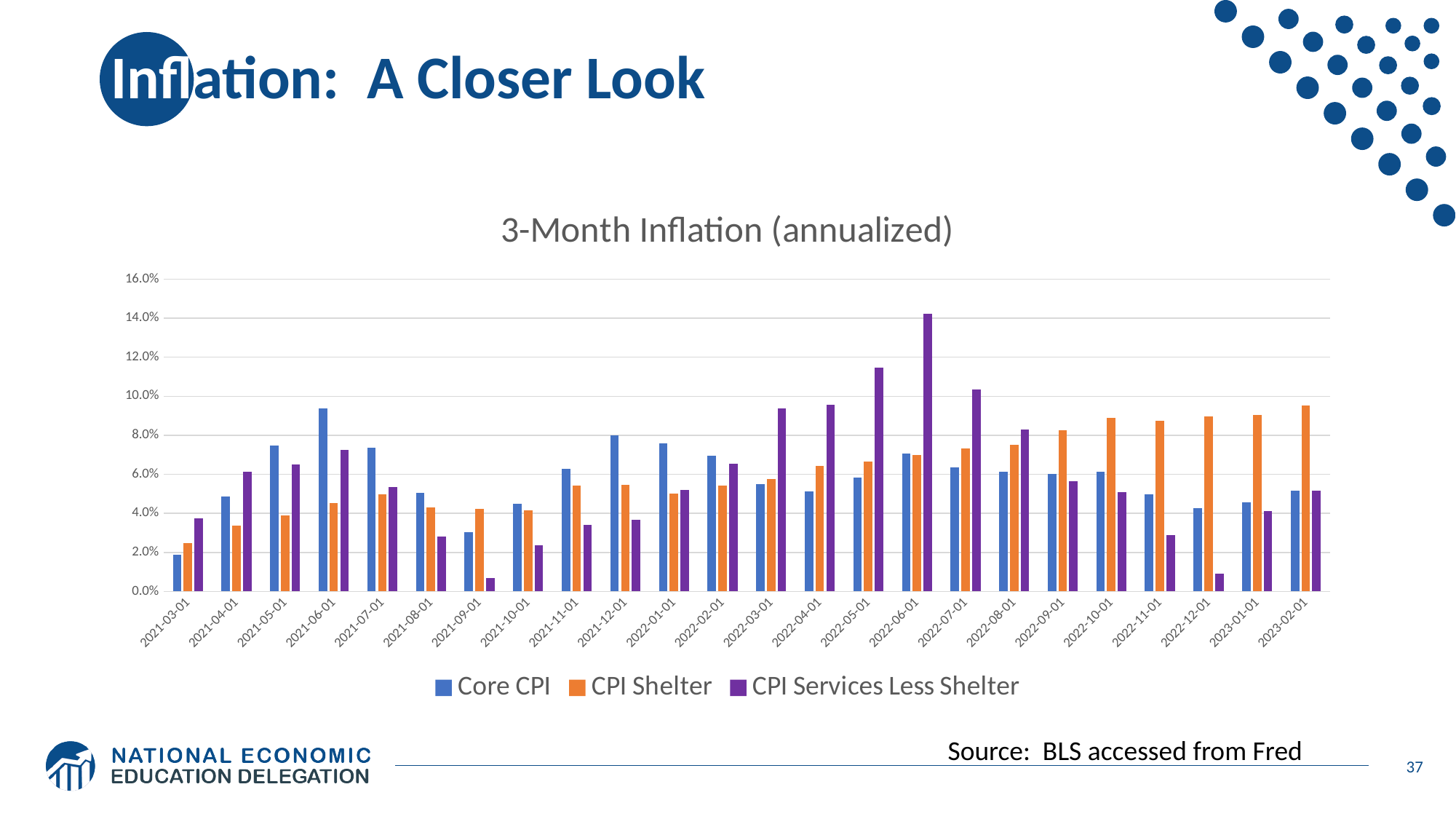
What type of chart is shown on the slide? bar chart In which month is CPI Services Less Shelter lowest? 2021-09-01 In which month is CPI Services Less Shelter highest? 2022-06-01 In 2022-05-01, which is larger: Core CPI or CPI Services Less Shelter? CPI Services Less Shelter Is the value for CPI Services Less Shelter in 2022-12-01 greater or less than 2.0%? less In which month is Core CPI highest? 2021-06-01 How many months (categories) are shown on the x axis? 24 What is the title of the chart? 3-Month Inflation (annualized) How many series does the legend list? 3 In which month is Core CPI lowest? 2021-03-01 Is the value for CPI Services Less Shelter in 2022-06-01 greater or less than 12.0%? greater Is the value for Core CPI in 2021-06-01 greater or less than 8.0%? greater